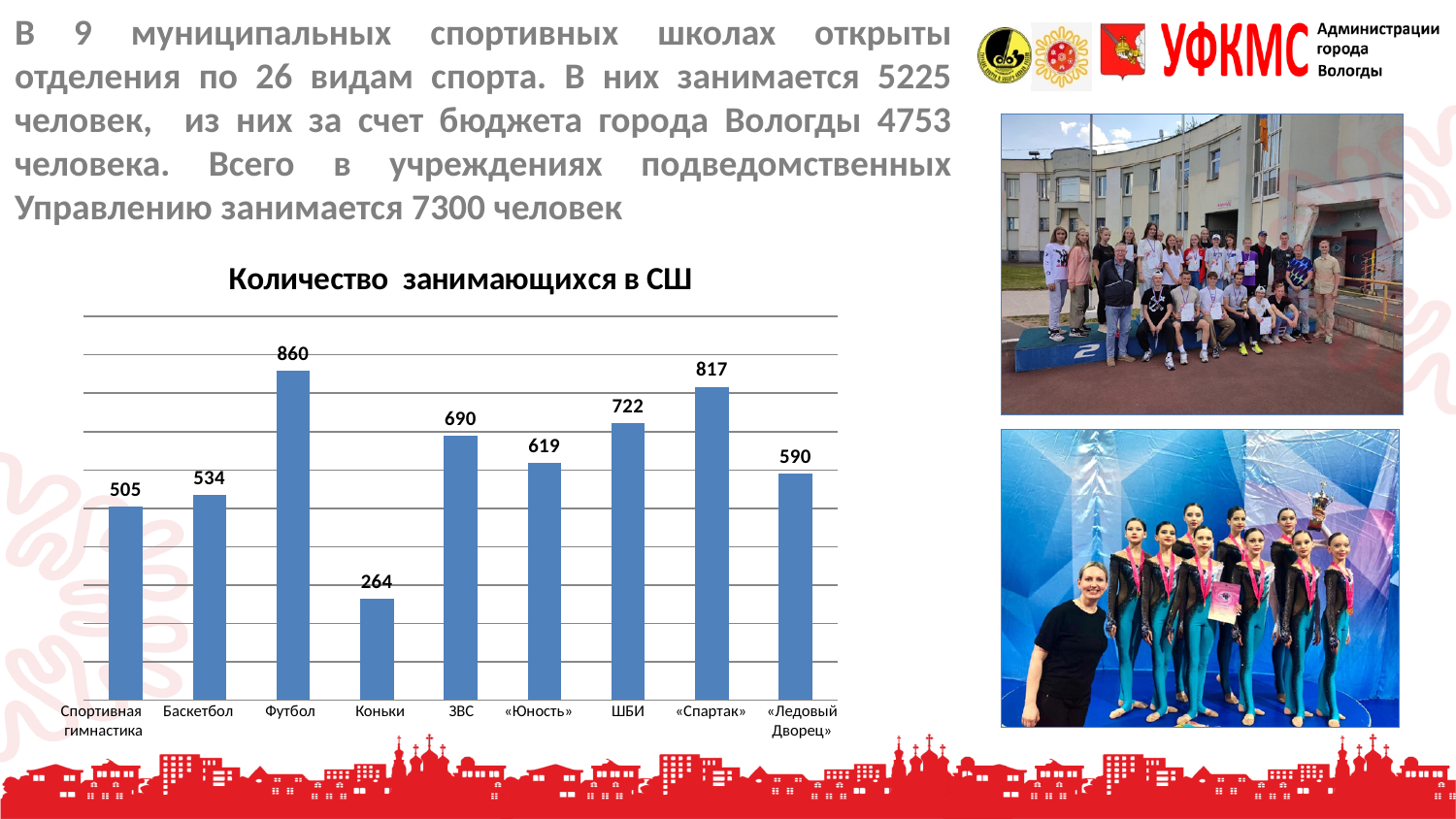
What kind of chart is shown on the slide? Bar chart What is the value for Коньки in the chart? 264 What is the value for Футбол in the chart 'Количество занимающихся в СШ'? 860 What is the difference between the values for ШБИ and «Юность»? 103 How many categories are shown in the chart? 9 What is the difference between the values for Футбол and Коньки? 596 What is the value for «Спартак» in the chart? 817 What is the value for ЗВС in the chart? 690 What is the title of the chart on the slide? Количество занимающихся в СШ Which is larger, the value for Баскетбол or the value for «Ледовый Дворец»? «Ледовый Дворец» Which category has the lowest value in the chart? Коньки Which category has the highest value in the chart? Футбол